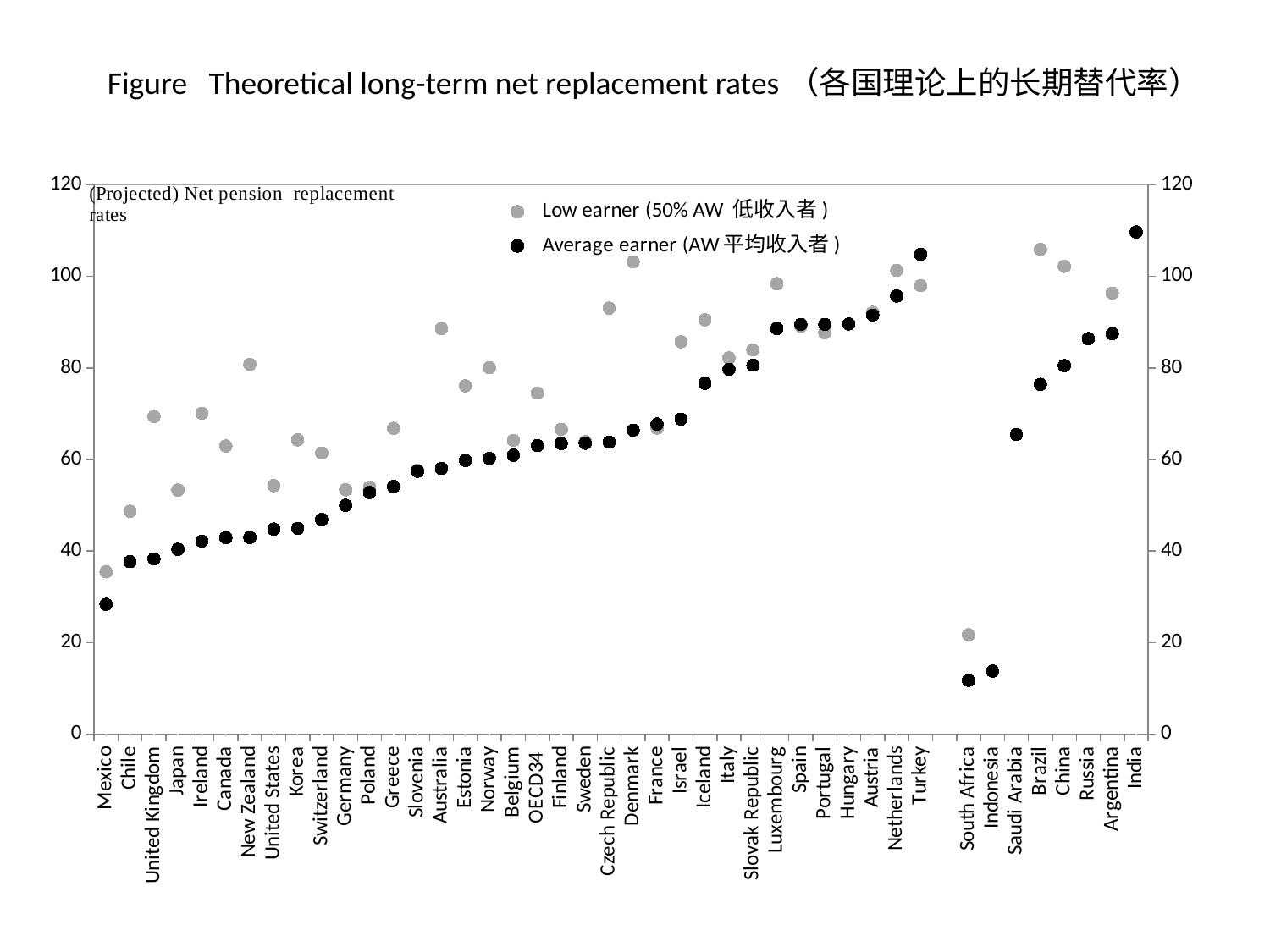
How many series does the legend list? 2 Which category has the highest Average earner (AW) value? India Is the Low earner value for Chile greater or less than 60? less Which category has the lowest Low earner (50% AW) value? Indonesia Is the Average earner value for Mexico greater or less than 40? less What kind of chart is shown on the slide? scatter (dot) chart How many countries/categories are shown on the x axis? 43 Which category has the lowest Average earner (AW) value? South Africa Is the Average earner value for Turkey greater or less than 100? greater Do the Average earner values rise or fall along the x axis from Mexico to Turkey? rise For Mexico, which is larger: the Low earner value or the Average earner value? Low earner